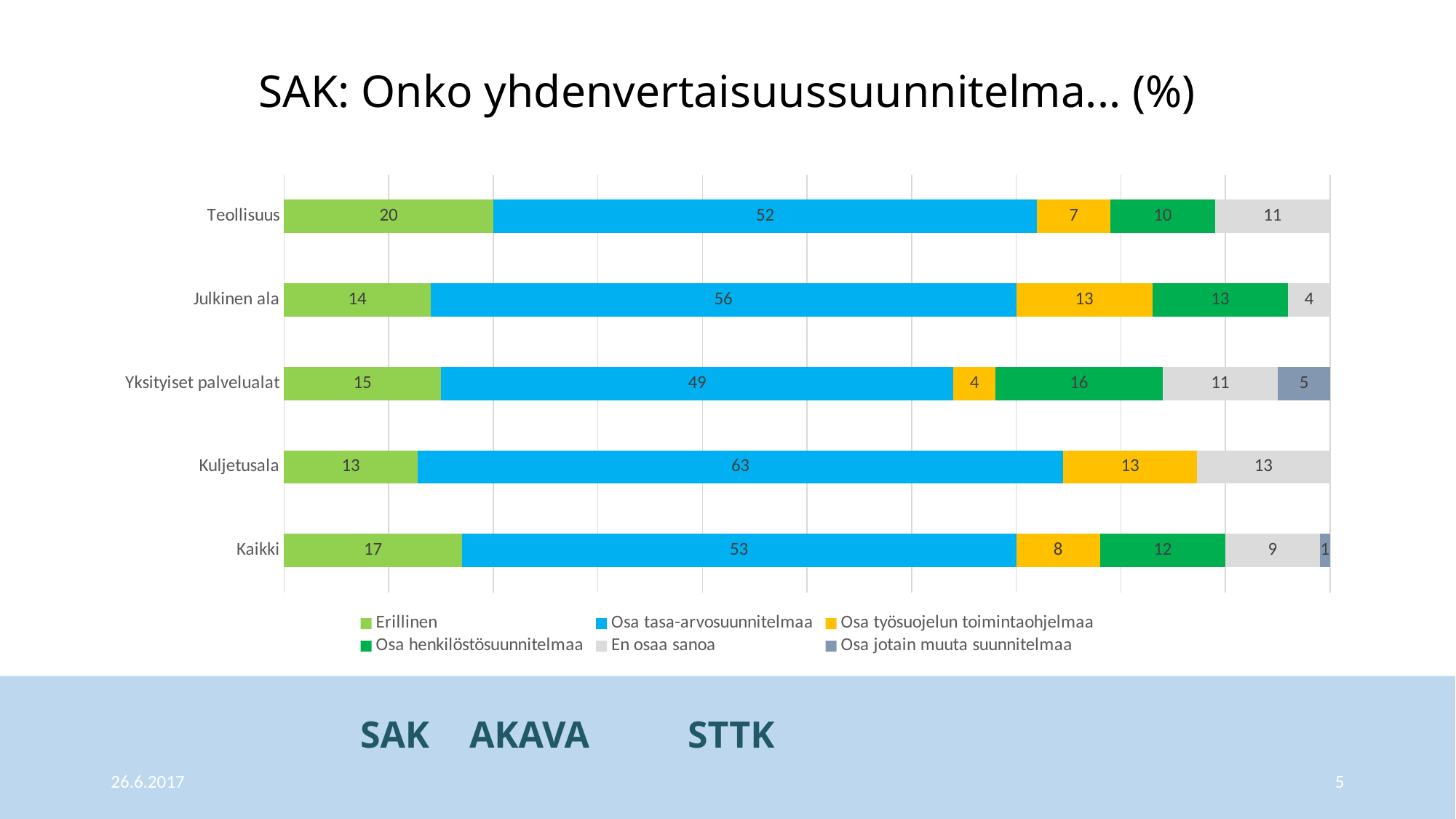
What kind of chart is shown on the slide? Stacked bar chart Which is larger: the Erillinen value for Teollisuus or for Julkinen ala? Teollisuus What is the total of the stacked bar for Kuljetusala? 102 What is the value of Osa henkilöstösuunnitelmaa for Yksityiset palvelualat? 16 What is the value of Osa tasa-arvosuunnitelmaa for Teollisuus? 52 Which category has the highest value for Osa tasa-arvosuunnitelmaa? Kuljetusala What is the value of Erillinen for Kaikki? 17 Which category has the lowest value for Erillinen? Kuljetusala How many series does the legend list? 6 What is the difference between the Osa tasa-arvosuunnitelmaa values for Kuljetusala and Yksityiset palvelualat? 14 What is the value of En osaa sanoa for Julkinen ala? 4 How many categories are shown on the y axis? 5